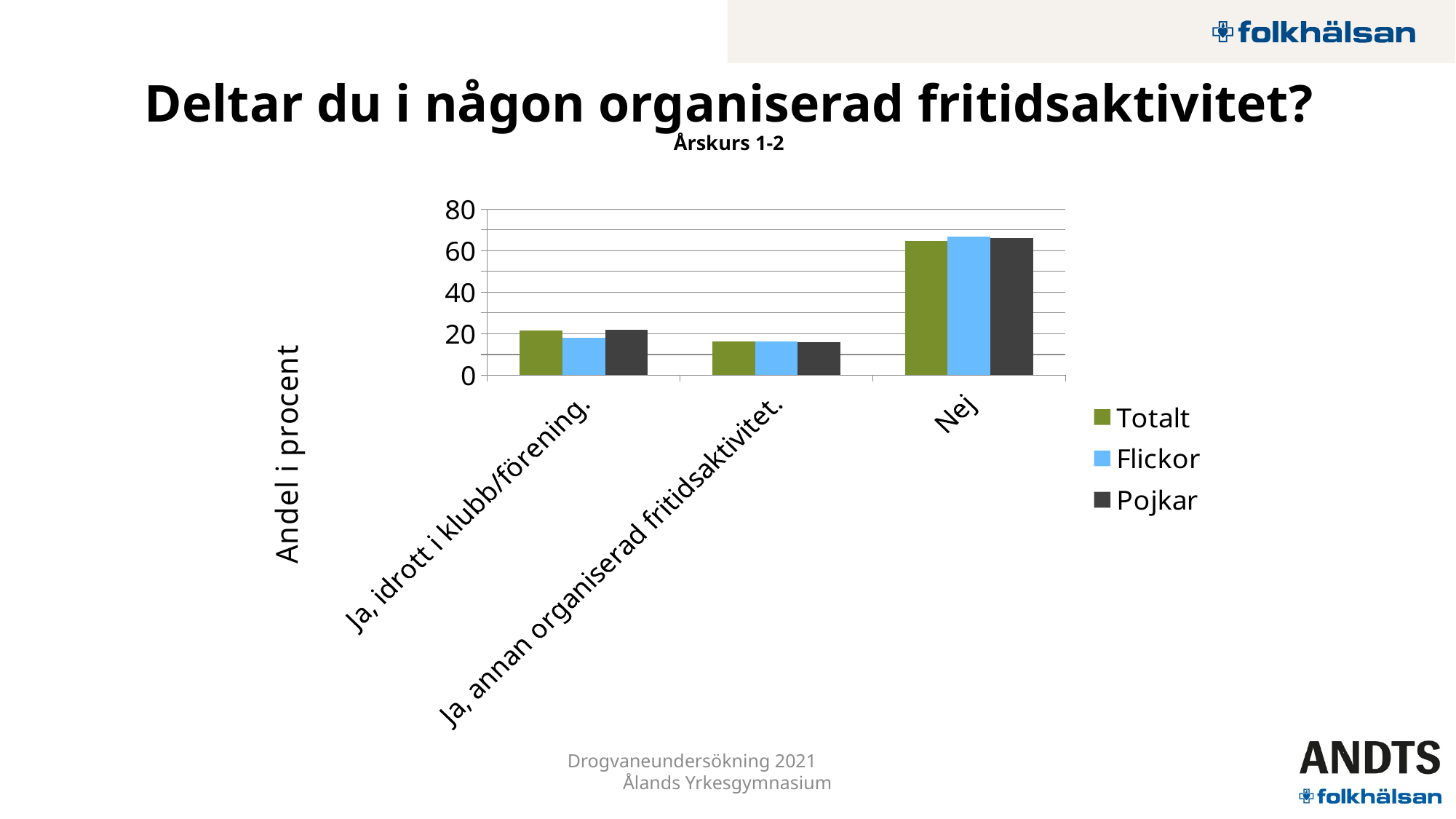
Which series is shown in light blue in the legend? Flickor Is the Pojkar value for Nej greater or less than 40? greater Is the Pojkar value for 'Ja, annan organiserad fritidsaktivitet.' greater or less than 20? less Which category has the highest value for the Totalt series? Nej Is the Totalt value for Nej greater or less than 60? greater How many categories are shown on the x axis of the chart? 3 How many series does the chart's legend list? 3 What is the title of the chart's vertical axis? Andel i procent Which category has the lowest value for the Totalt series? Ja, annan organiserad fritidsaktivitet. What kind of chart is shown on the slide? bar chart For the Flickor series, which is larger: the value for Nej or the value for 'Ja, idrott i klubb/förening.'? Nej